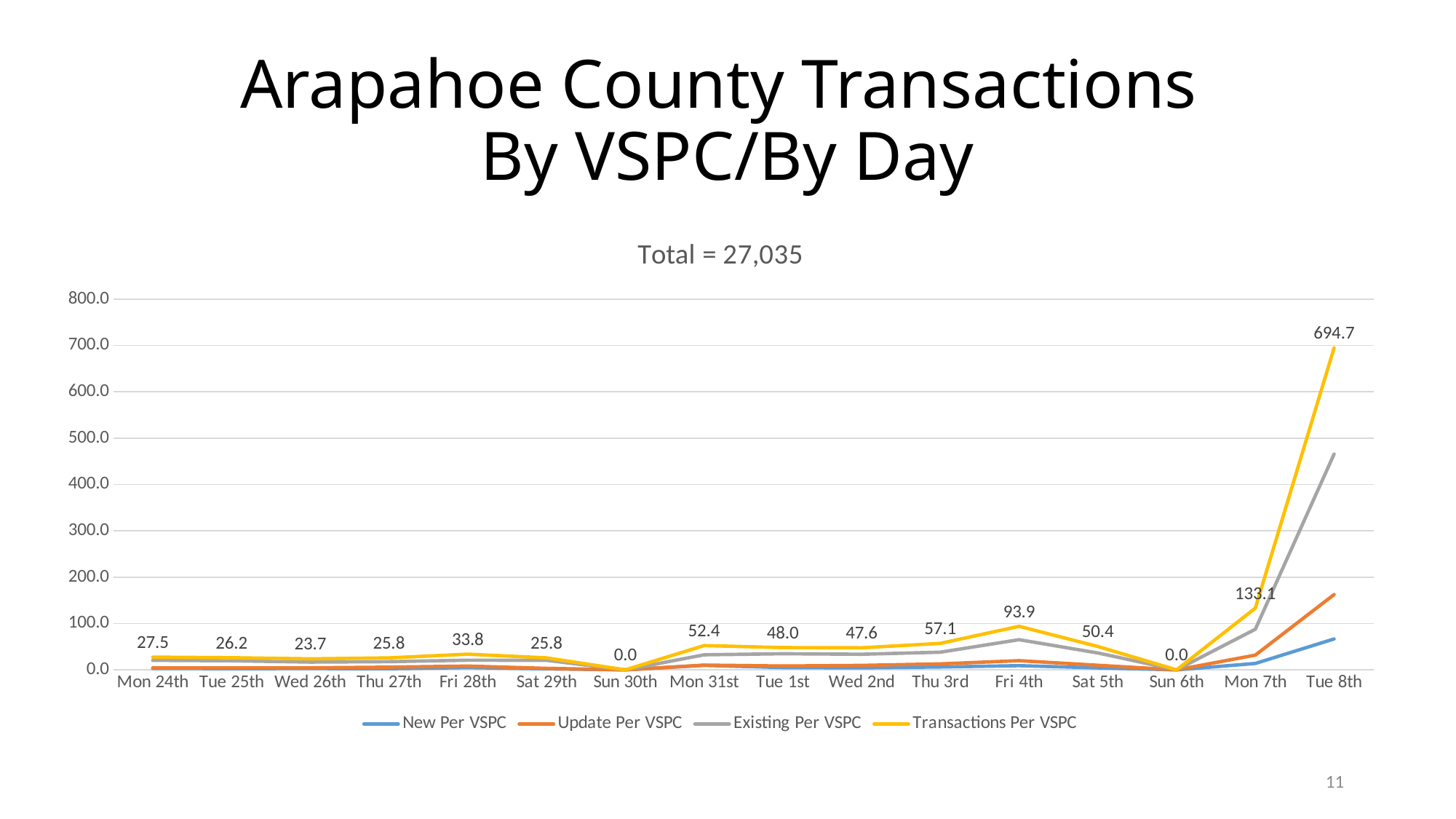
Is the Existing Per VSPC value on Tue 8th greater or less than 400? greater What is the Transactions Per VSPC value on Fri 4th? 93.9 What is the lowest Transactions Per VSPC value shown on the chart? 0.0 What total is stated above the chart? Total = 27,035 What is the difference between the Transactions Per VSPC values on Tue 8th and Mon 7th? 561.6 On which day is Transactions Per VSPC highest? Tue 8th Which is larger, the Transactions Per VSPC value on Mon 31st or on Tue 1st? Mon 31st What type of chart is shown on the slide? line chart What is the Transactions Per VSPC value on Tue 8th? 694.7 How many series does the legend list? 4 What is the Transactions Per VSPC value on Mon 7th? 133.1 How many days are plotted along the x axis? 16